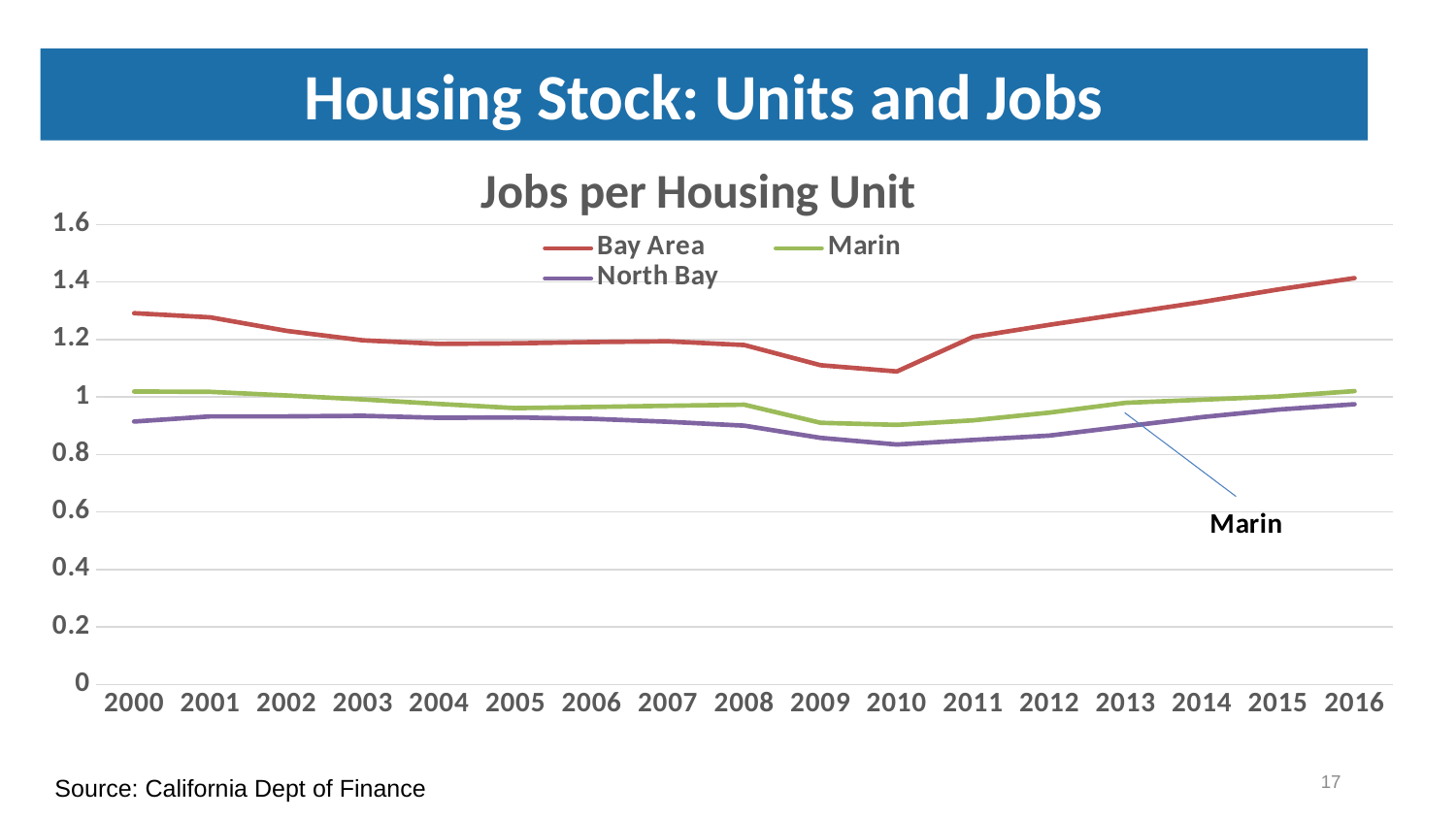
In which year does the Bay Area series reach its highest value? 2016 Which series has the lowest jobs per housing unit across all years? North Bay What is the title of the chart? Jobs per Housing Unit Is the Marin value for 2010 greater or less than 1? less Does the Bay Area series rise or fall from 2010 to 2016? rise How many series does the legend list? 3 In which year does the Bay Area series reach its lowest value? 2010 Which series has the highest jobs per housing unit across all years? Bay Area In 2010, which is larger: the Marin value or the North Bay value? Marin Is the Bay Area value for 2010 greater or less than 1.2? less How many years are plotted along the x axis? 17 What kind of chart is shown on the slide? Line chart